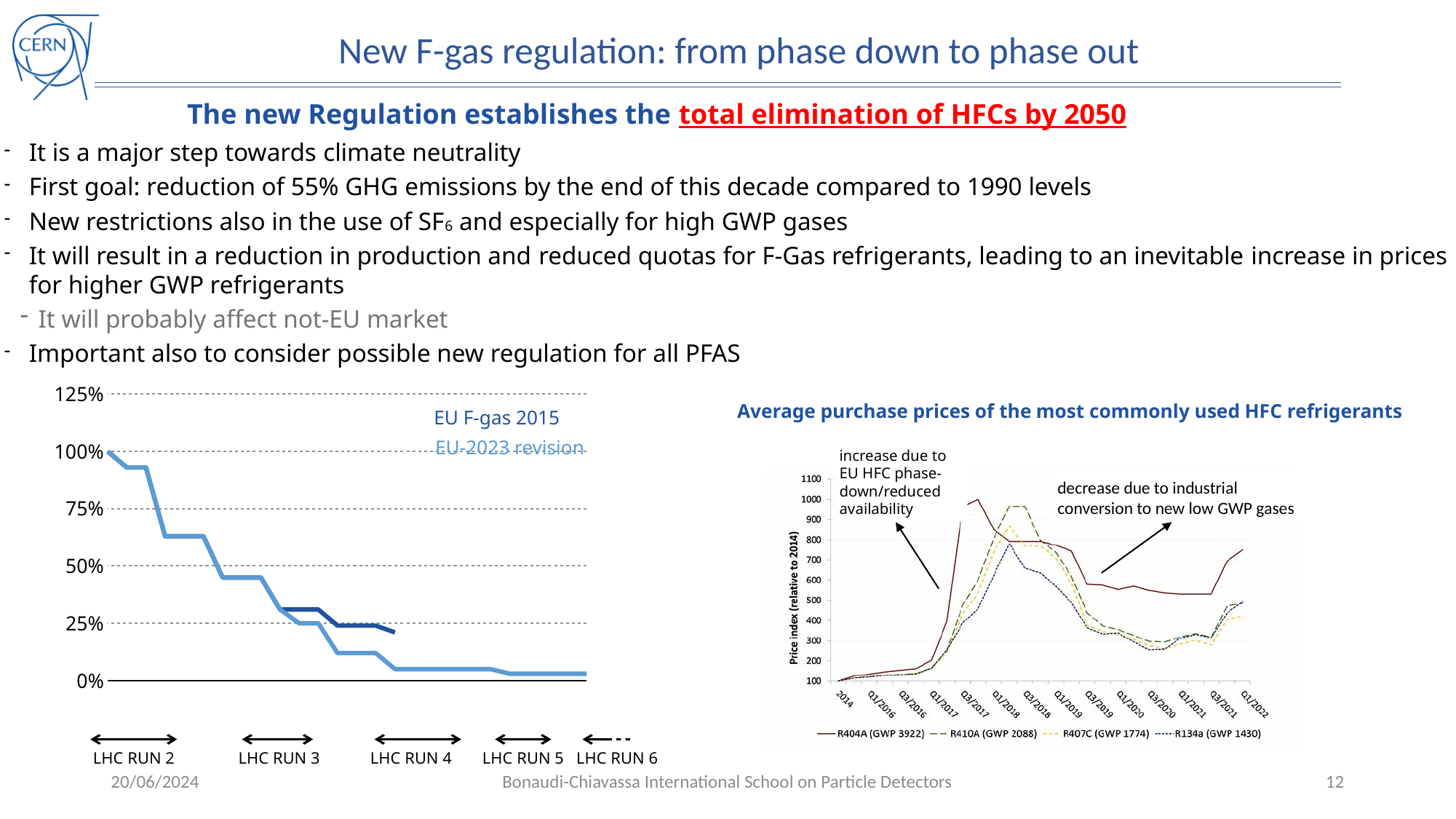
In the right chart, what is the price index value of the series at the 2014 starting point? 100 In the right chart, which refrigerant series reaches the highest price index? R404A (GWP 3922) What kind of chart is the left chart showing the EU F-gas phase-down? line chart What is the title of the right chart? Average purchase prices of the most commonly used HFC refrigerants How many series does the legend of the right chart list? 4 In the left chart, what is the starting value of the EU F-gas 2015 line at the first point? 100% In the right chart, is the peak value of R404A greater or less than 900? greater In the left chart, is the final value of the EU F-gas 2015 line greater or less than 25%? less How many LHC RUN periods are labelled below the left chart? 5 In the left chart, do the values rise or fall along the x axis? fall How many series does the legend of the left chart list? 2 In the right chart, is the peak value of R134a greater or less than 900? less